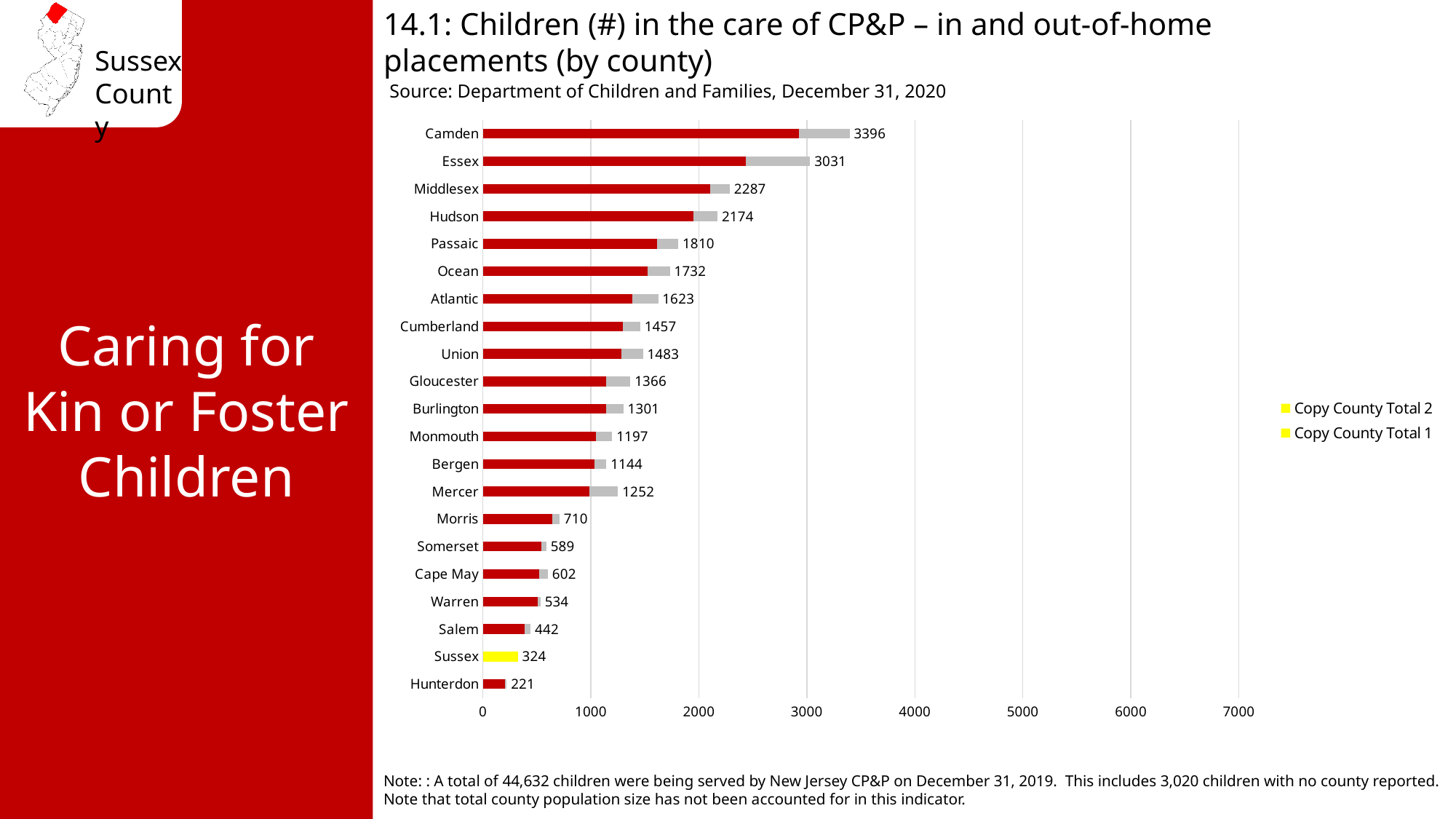
What is the difference between the labelled totals for Mercer and Bergen? 108 What is the difference between the labelled totals for Camden and Essex? 365 Which county has the highest labelled total on the chart? Camden How many counties are listed on the chart? 21 Which county has the lowest labelled total on the chart? Hunterdon What kind of chart is shown on the slide? Stacked bar chart How many series does the legend list? 2 What value is labelled for Sussex on the chart? 324 Is the labelled total for Hudson greater or less than 2000? greater What is the total number of children in the care of CP&P shown for Camden? 3396 Which county's bar is highlighted in yellow on the chart? Sussex Which has a larger labelled total, Union or Cumberland? Union